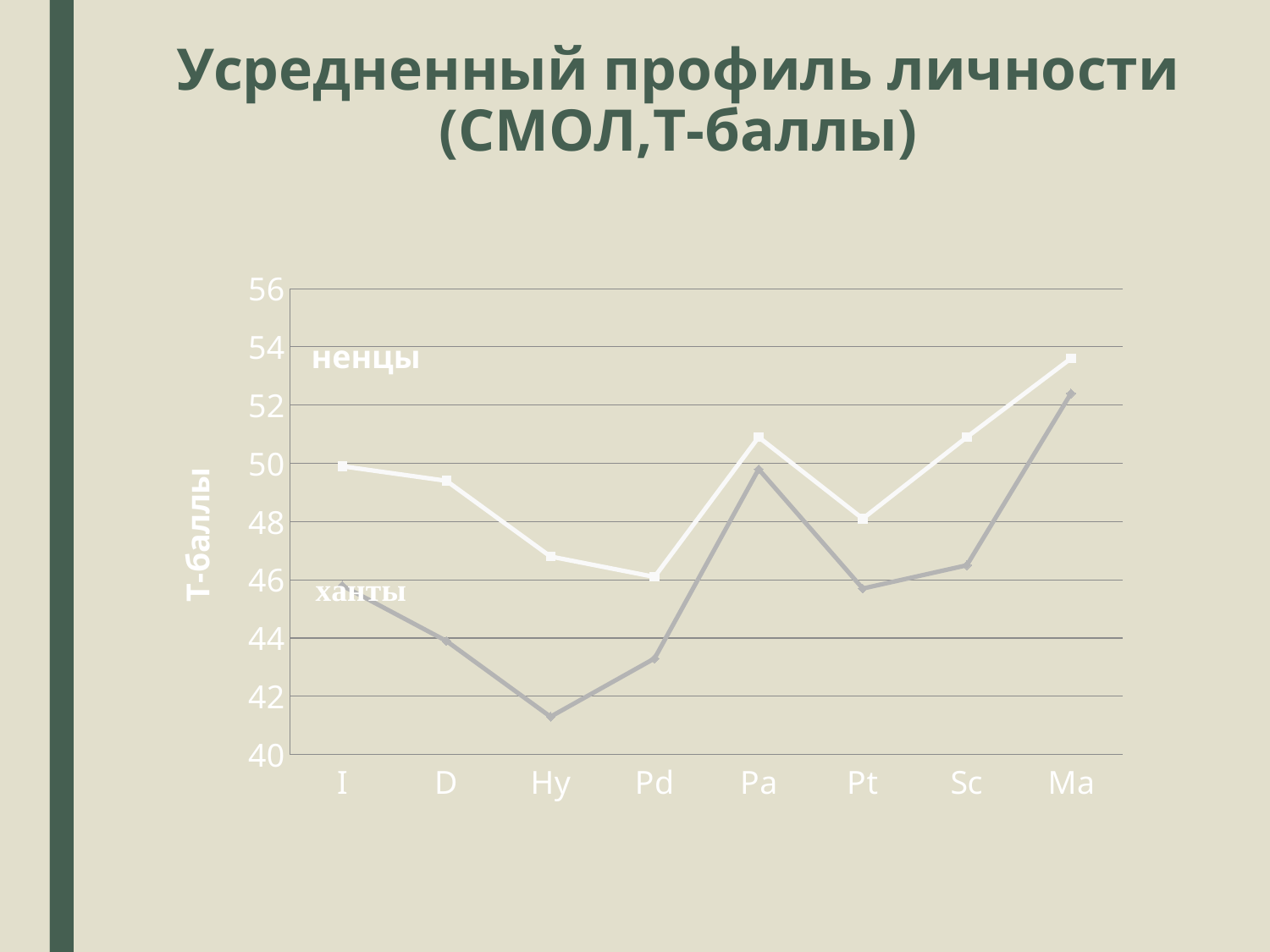
Is the value for ненцы at Ma greater or less than 52? greater Is the value for ханты at Hy greater or less than 42? less For the ханты series, which category has the lowest value? Hy At category Hy, which series has the larger value, ненцы or ханты? ненцы How many categories are shown along the x axis? 8 What is the label of the vertical axis? Т-баллы For the ханты series, which category has the highest value? Ma How many data series are plotted on the chart? 2 What kind of chart is shown on the slide? line chart Does the ненцы series rise or fall from I to Hy? fall For the ненцы series, which category has the highest value? Ma